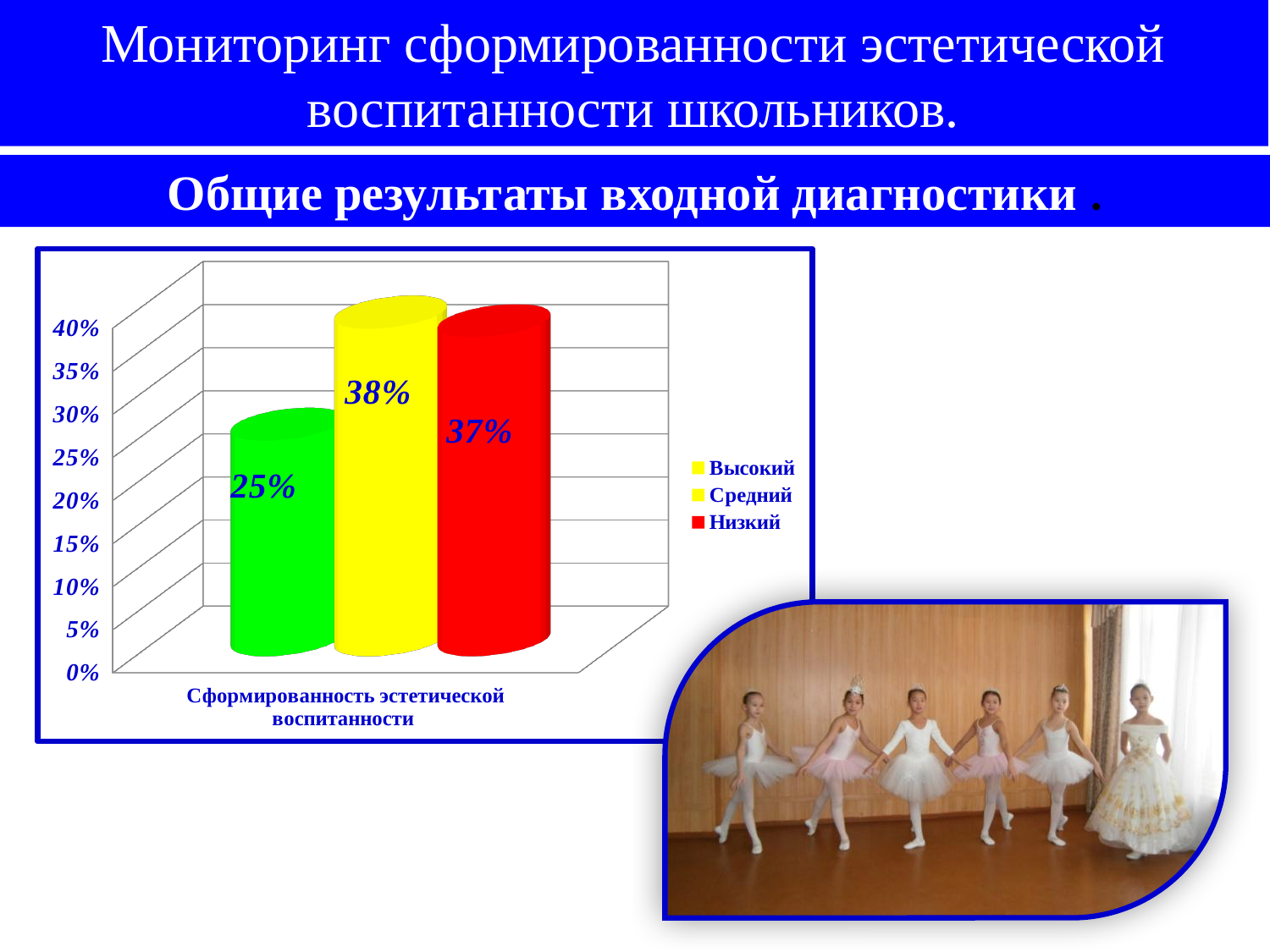
What is the difference between the yellow bar's value and the green bar's value? 13% Is the value of the green bar greater or less than 30%? less What value is shown on the green bar in the chart? 25% How many bars are plotted in the chart? 3 What value is shown on the red bar (Низкий) in the chart? 37% Which bar has the lowest value in the chart? The green bar (25%) Which bar has the highest value in the chart? The yellow bar (38%) How many entries does the chart legend list? 3 What is the difference between the yellow bar's value and the red bar's value? 1% What type of chart is shown on the slide? Bar chart What value is shown on the yellow bar in the chart? 38% Which is larger, the value of the red bar or the value of the green bar? The red bar